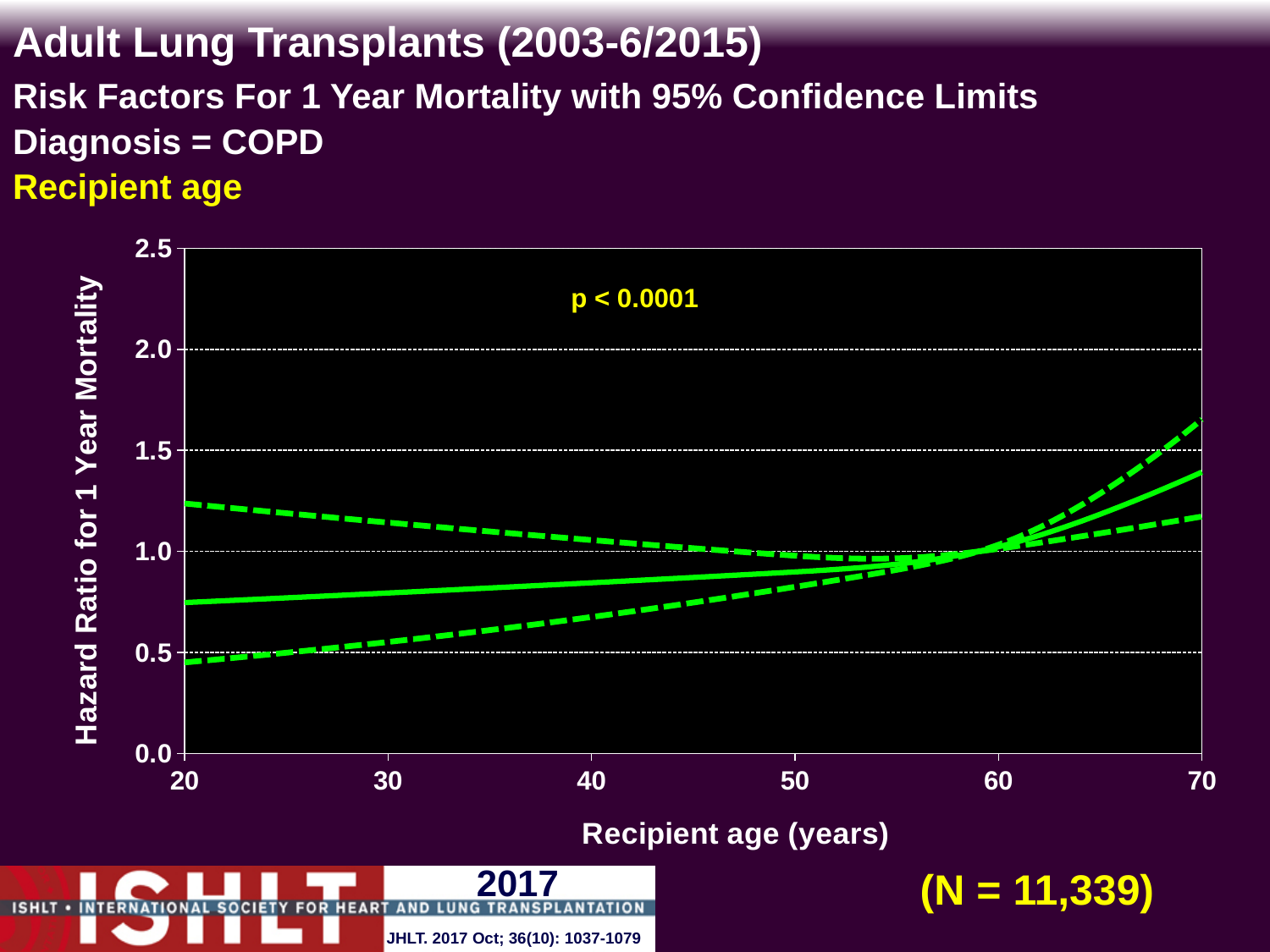
What is the sample size (N) shown on the slide? N = 11,339 Is the hazard ratio (solid line) at recipient age 40 greater or less than 1.0? less Is the hazard ratio (solid line) at recipient age 70 greater or less than 1.0? greater Is the lower 95% confidence limit at recipient age 70 greater or less than 1.0? greater What kind of chart is shown on the slide? line chart What p-value is printed on the chart? p < 0.0001 Does the hazard ratio for 1 year mortality (solid line) rise or fall as recipient age increases from 20 to 70 years? rise Is the hazard ratio (solid line) higher at recipient age 70 or at recipient age 20? 70 How many lines are plotted on the chart? 3